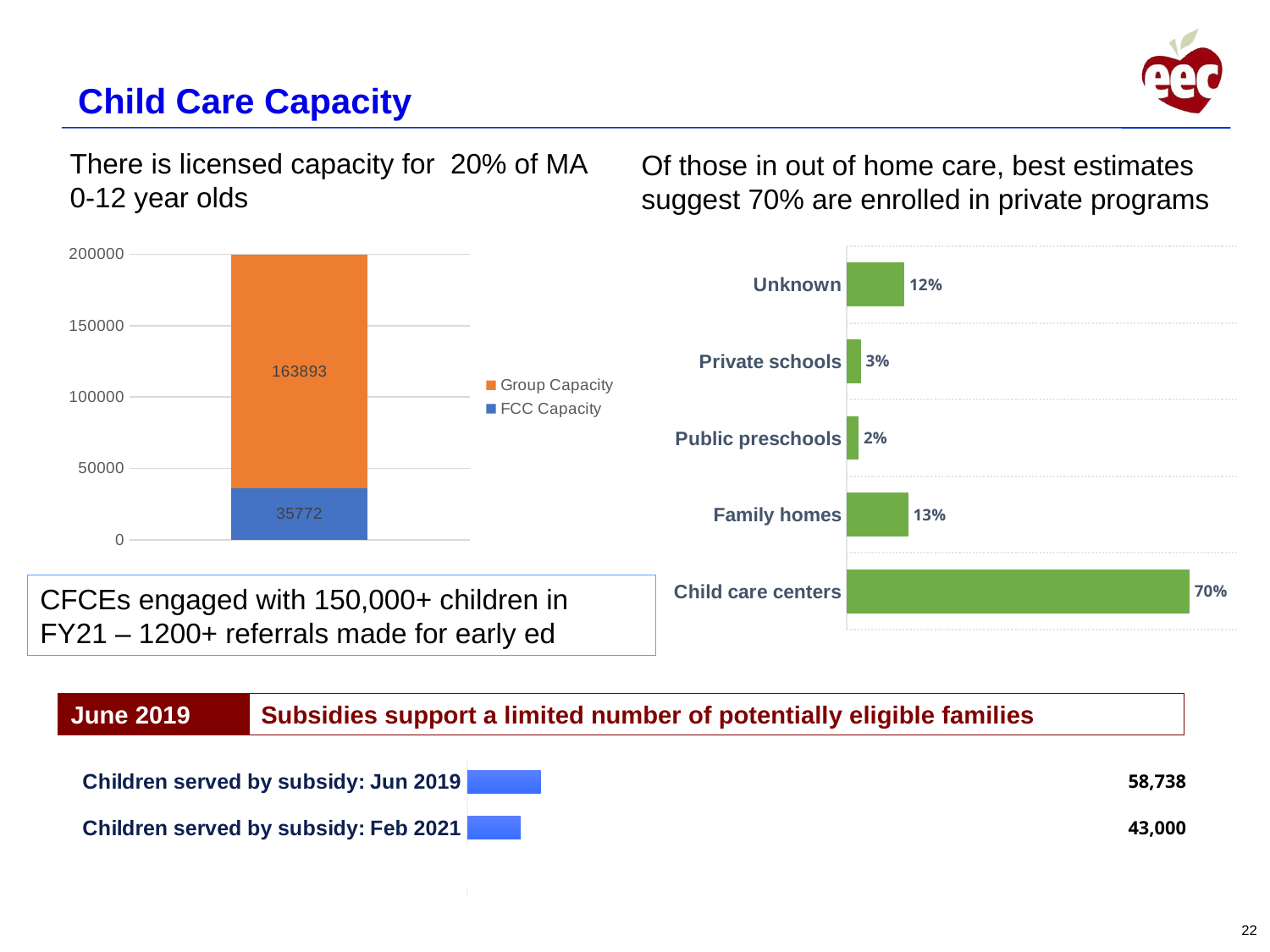
In the bottom chart, what is the difference between children served by subsidy in Jun 2019 and Feb 2021? 15,738 In the stacked bar chart on the left, how many series does the legend list? 2 In the horizontal bar chart on the right, which category has the highest value? Child care centers In the stacked bar chart on the left, what is the value for Group Capacity? 163893 In the bottom chart, how many children were served by subsidy in Feb 2021? 43,000 In the horizontal bar chart on the right, how many categories are shown? 5 In the horizontal bar chart on the right, which category has the lowest value? Public preschools In the horizontal bar chart on the right, what is the value for Family homes? 13% In the stacked bar chart on the left, what is the value for FCC Capacity? 35772 In the horizontal bar chart on the right, what is the difference between Child care centers and Family homes? 57% In the stacked bar chart on the left, which series is larger, Group Capacity or FCC Capacity? Group Capacity In the stacked bar chart on the left, what is the total of the stacked bar? 199665